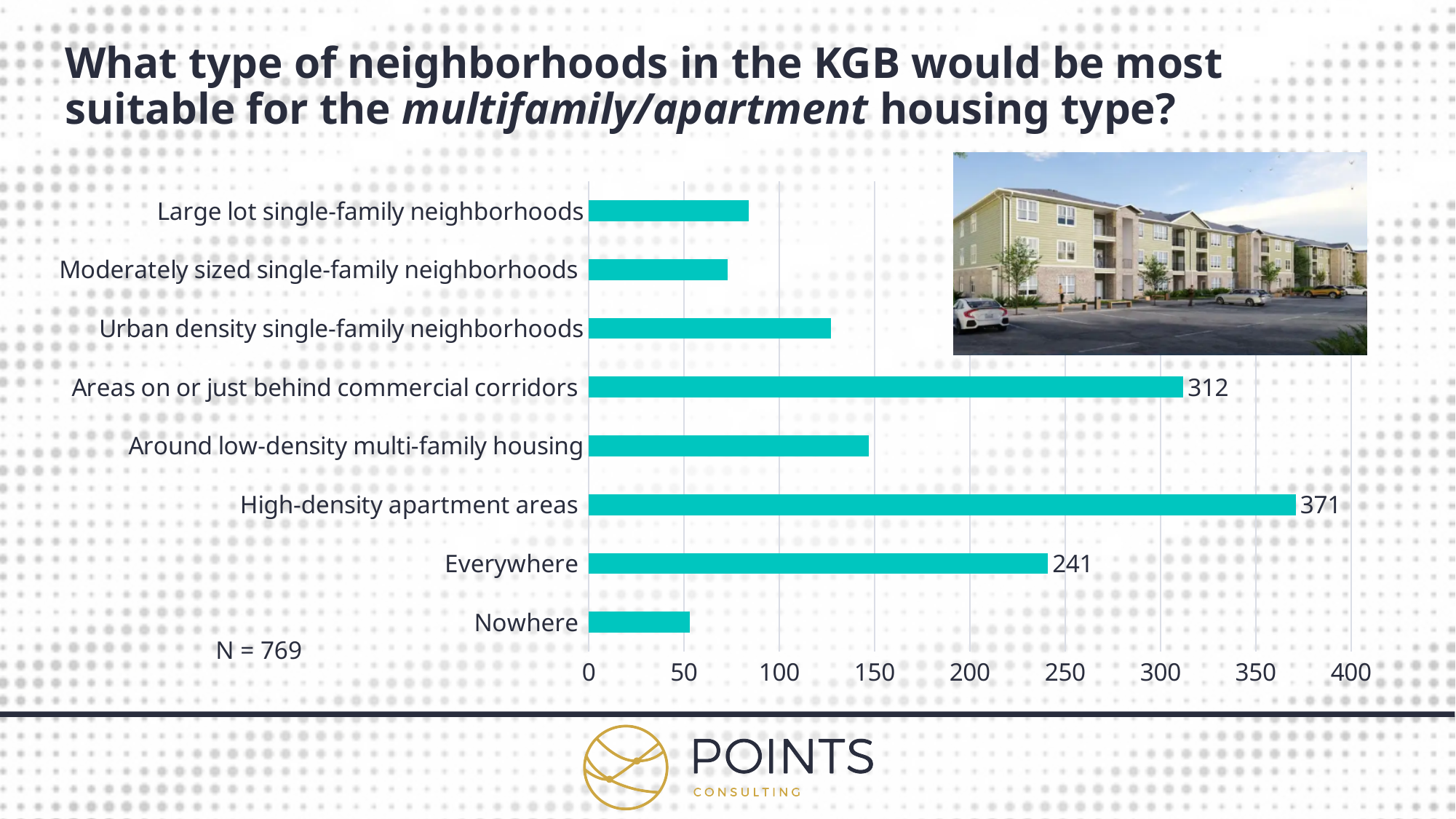
Which category has the lowest value? Nowhere What is the value for High-density apartment areas? 371 Which is larger, the value for Everywhere or the value for Areas on or just behind commercial corridors? Areas on or just behind commercial corridors Is the value for Large lot single-family neighborhoods greater or less than 100? less What kind of chart is shown on the slide? bar chart How many categories are shown in the chart? 8 Is the value for Urban density single-family neighborhoods greater or less than 100? greater What is the difference between the values for Areas on or just behind commercial corridors and Everywhere? 71 What is the value for Areas on or just behind commercial corridors? 312 What is the value for Everywhere? 241 What is the difference between the values for High-density apartment areas and Areas on or just behind commercial corridors? 59 Which category has the highest value? High-density apartment areas